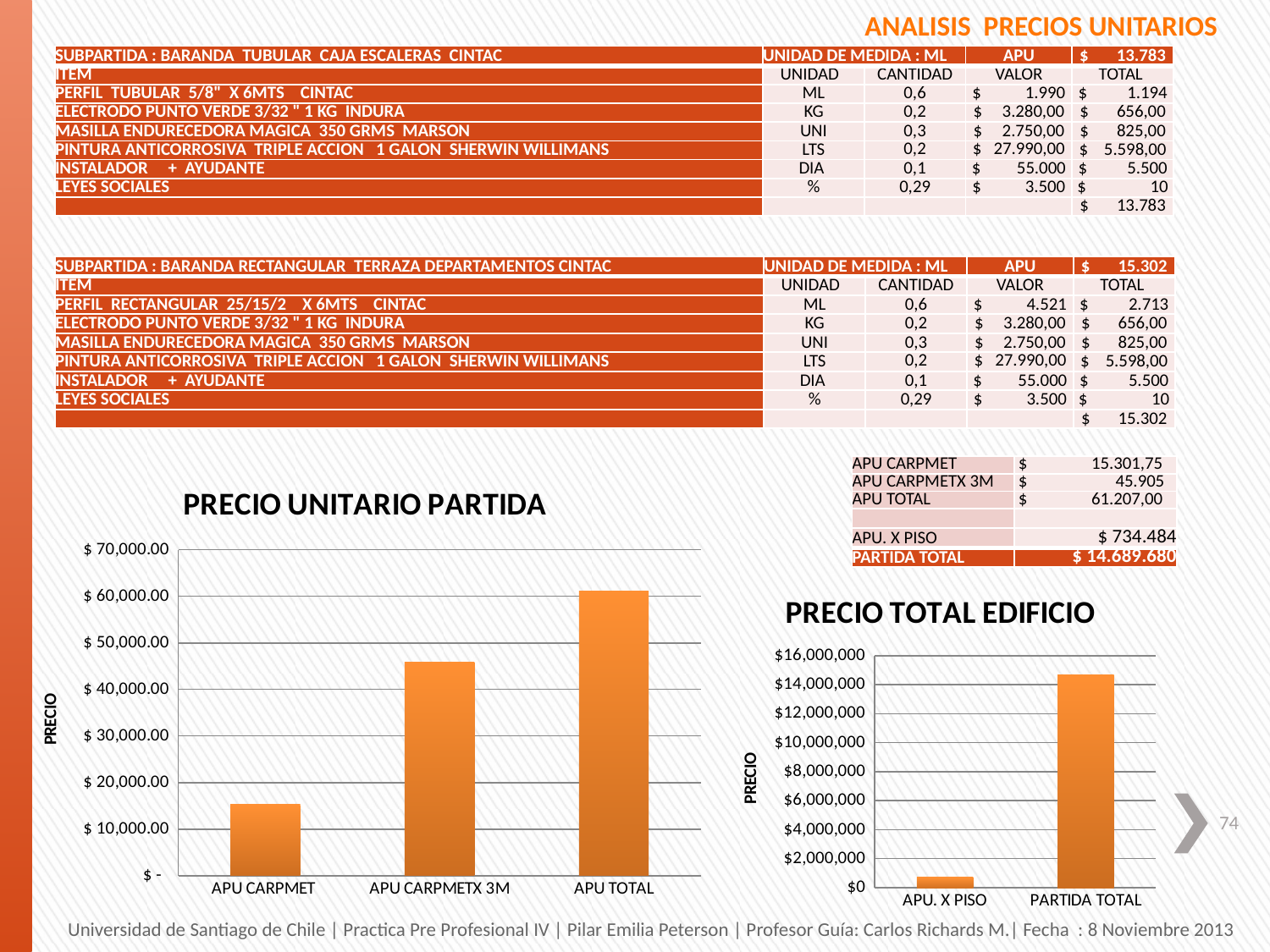
In the PRECIO UNITARIO PARTIDA chart, which category has the highest value? APU TOTAL In the PRECIO UNITARIO PARTIDA chart, is the value for APU CARPMET greater or less than $20,000.00? less In the PRECIO UNITARIO PARTIDA chart, how many categories are shown on the x axis? 3 In the PRECIO UNITARIO PARTIDA chart, do the values rise or fall from left to right along the x axis? rise In the PRECIO UNITARIO PARTIDA chart, is the value for APU CARPMETX 3M greater or less than $40,000.00? greater In the PRECIO UNITARIO PARTIDA chart, which category has the lowest value? APU CARPMET What is the label on the y axis of the PRECIO TOTAL EDIFICIO chart? PRECIO In the PRECIO TOTAL EDIFICIO chart, is the value for APU. X PISO greater or less than $2,000,000? less In the PRECIO TOTAL EDIFICIO chart, which category has the higher value, APU. X PISO or PARTIDA TOTAL? PARTIDA TOTAL What kind of chart is PRECIO UNITARIO PARTIDA? bar chart